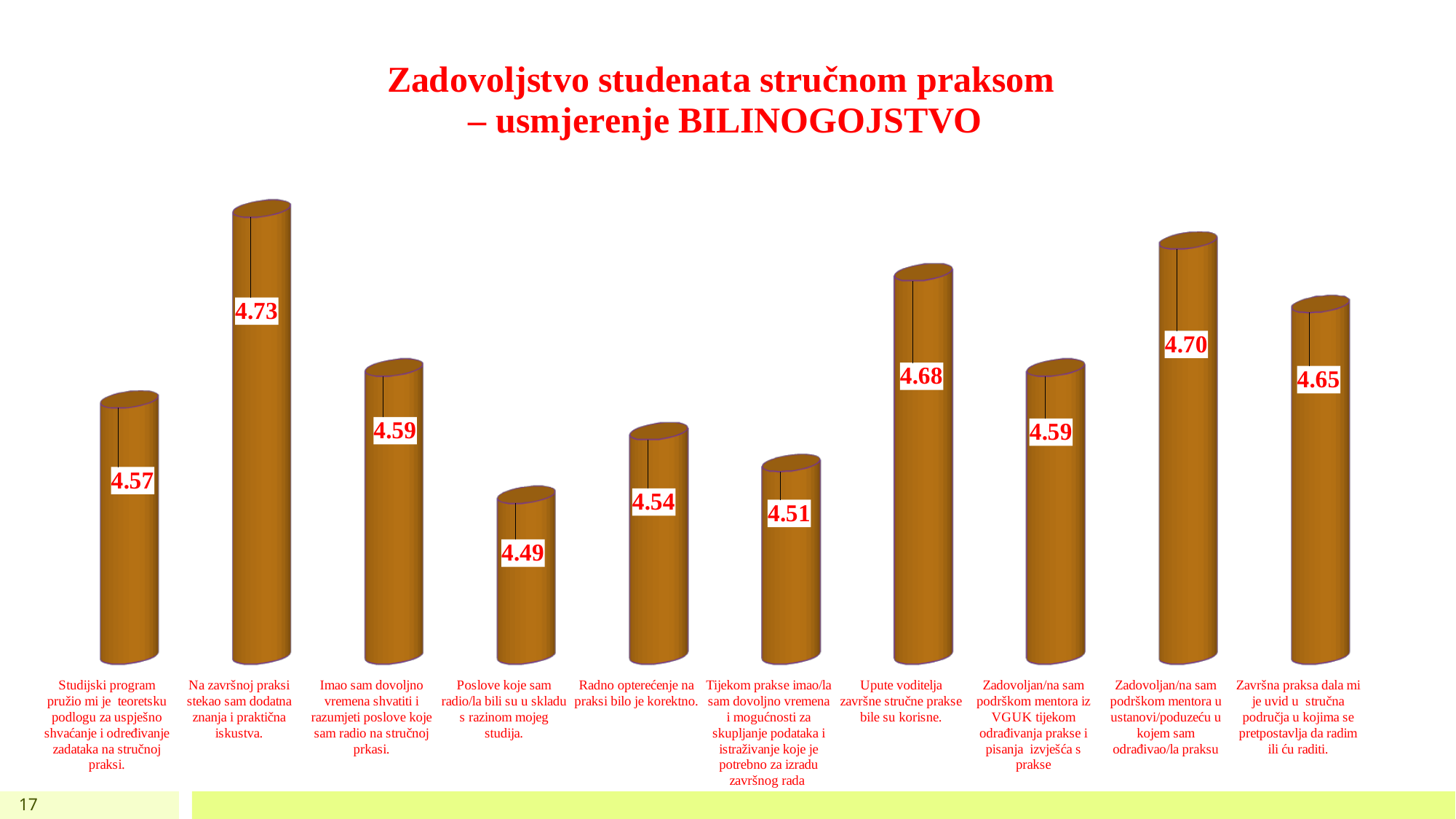
Which category has the highest value? Na završnoj praksi stekao sam dodatna znanja i praktična iskustva. What kind of chart is shown on the slide? bar chart What is the value for "Završna praksa dala mi je uvid u stručna područja u kojima se pretpostavlja da radim ili ću raditi."? 4.65 What is the value for "Radno opterećenje na praksi bilo je korektno."? 4.54 What is the chart's title? Zadovoljstvo studenata stručnom praksom – usmjerenje BILINOGOJSTVO What is the difference between the highest value (4.73) and the lowest value (4.49)? 0.24 What is the value for "Na završnoj praksi stekao sam dodatna znanja i praktična iskustva."? 4.73 How many categories (bars) does the chart show? 10 What is the value for "Upute voditelja završne stručne prakse bile su korisne."? 4.68 Which is larger: the value for "Zadovoljan/na sam podrškom mentora u ustanovi/poduzeću u kojem sam odrađivao/la praksu" or the value for "Zadovoljan/na sam podrškom mentora iz VGUK tijekom odrađivanja prakse i pisanja izvješća s prakse"? Zadovoljan/na sam podrškom mentora u ustanovi/poduzeću u kojem sam odrađivao/la praksu Which category has the lowest value? Poslove koje sam radio/la bili su u skladu s razinom mojeg studija. What is the difference between the value for "Studijski program pružio mi je teoretsku podlogu..." (4.57) and the value for "Tijekom prakse imao/la sam dovoljno vremena i mogućnosti..." (4.51)? 0.06